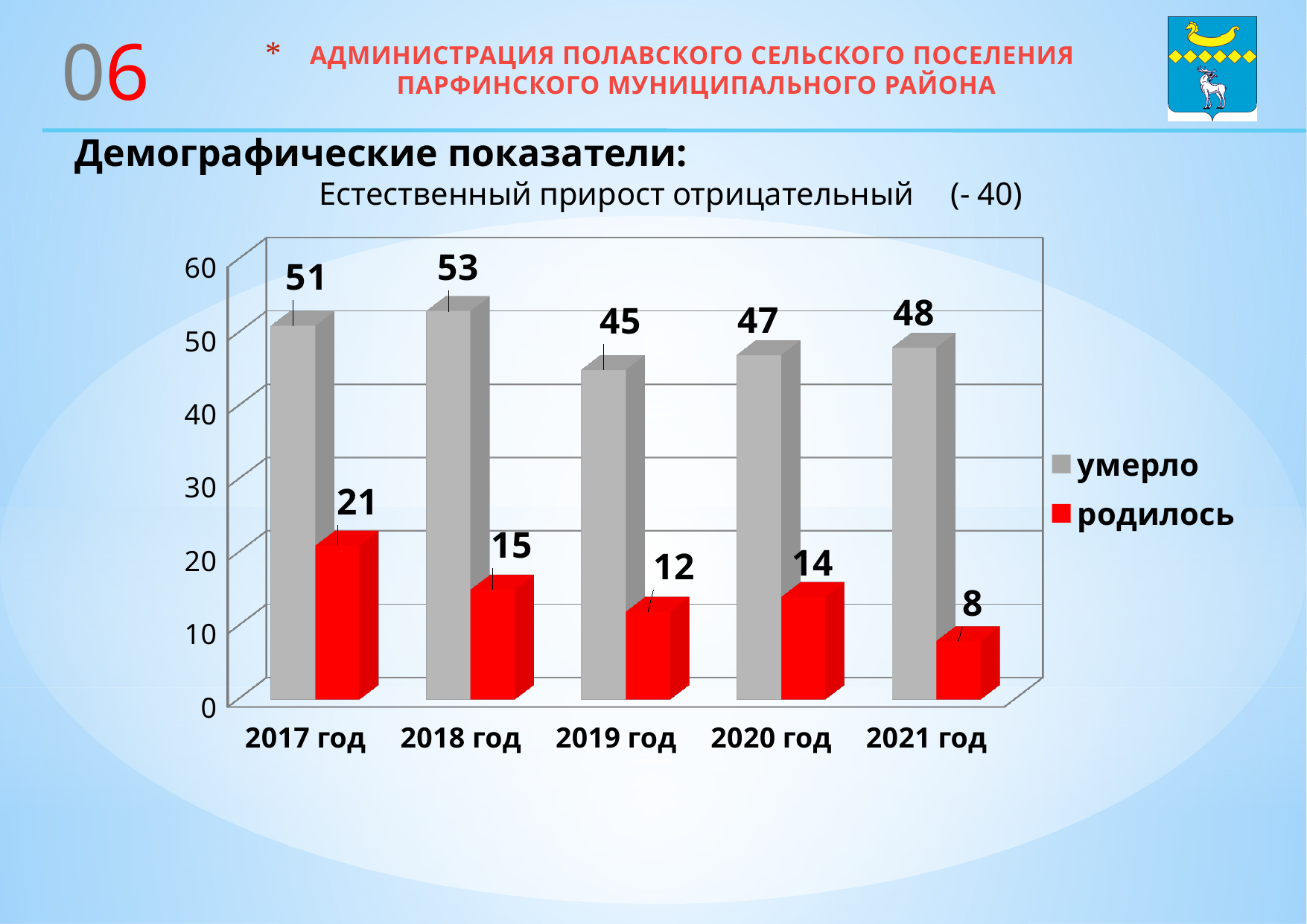
What is the value for умерло in 2019 год? 45 How many years are shown on the x axis? 5 How many series does the legend list? 2 In which year is the умерло value highest? 2018 год What is the value for родилось in 2021 год? 8 What kind of chart is shown on the slide? bar chart Does the родилось value rise or fall from 2017 год to 2021 год? fall In which year is the родилось value lowest? 2021 год Which colour represents the умерло series? grey What is the difference between умерло and родилось in 2020 год? 33 What is the value for родилось in 2017 год? 21 Which is larger: родилось in 2018 год or родилось in 2019 год? 2018 год